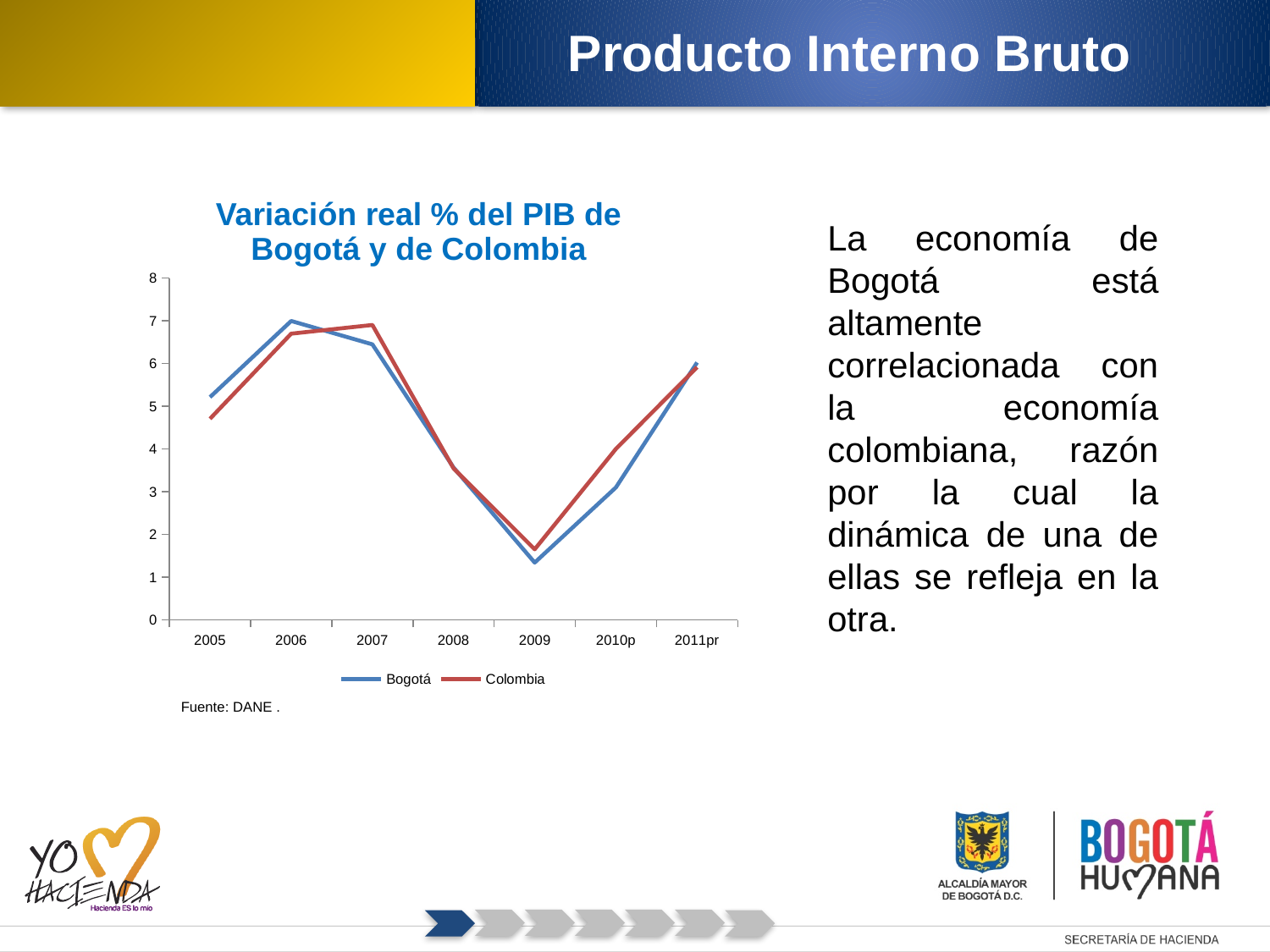
In which year does the Colombia series reach its lowest value? 2009 In 2010p, which series has the higher value, Bogotá or Colombia? Colombia In which year does the Bogotá series reach its highest value? 2006 Is the value for Colombia in 2005 greater or less than 4? greater Is the value for Bogotá in 2006 greater or less than 6? greater How many years are plotted along the x axis of the chart? 7 In 2005, which series has the higher value, Bogotá or Colombia? Bogotá Do the values for Bogotá rise or fall from 2007 to 2009? fall What kind of chart is shown on the slide? line chart Is the value for Bogotá in 2009 greater or less than 2? less How many series does the legend of the chart list? 2 In which year does the Bogotá series reach its lowest value? 2009